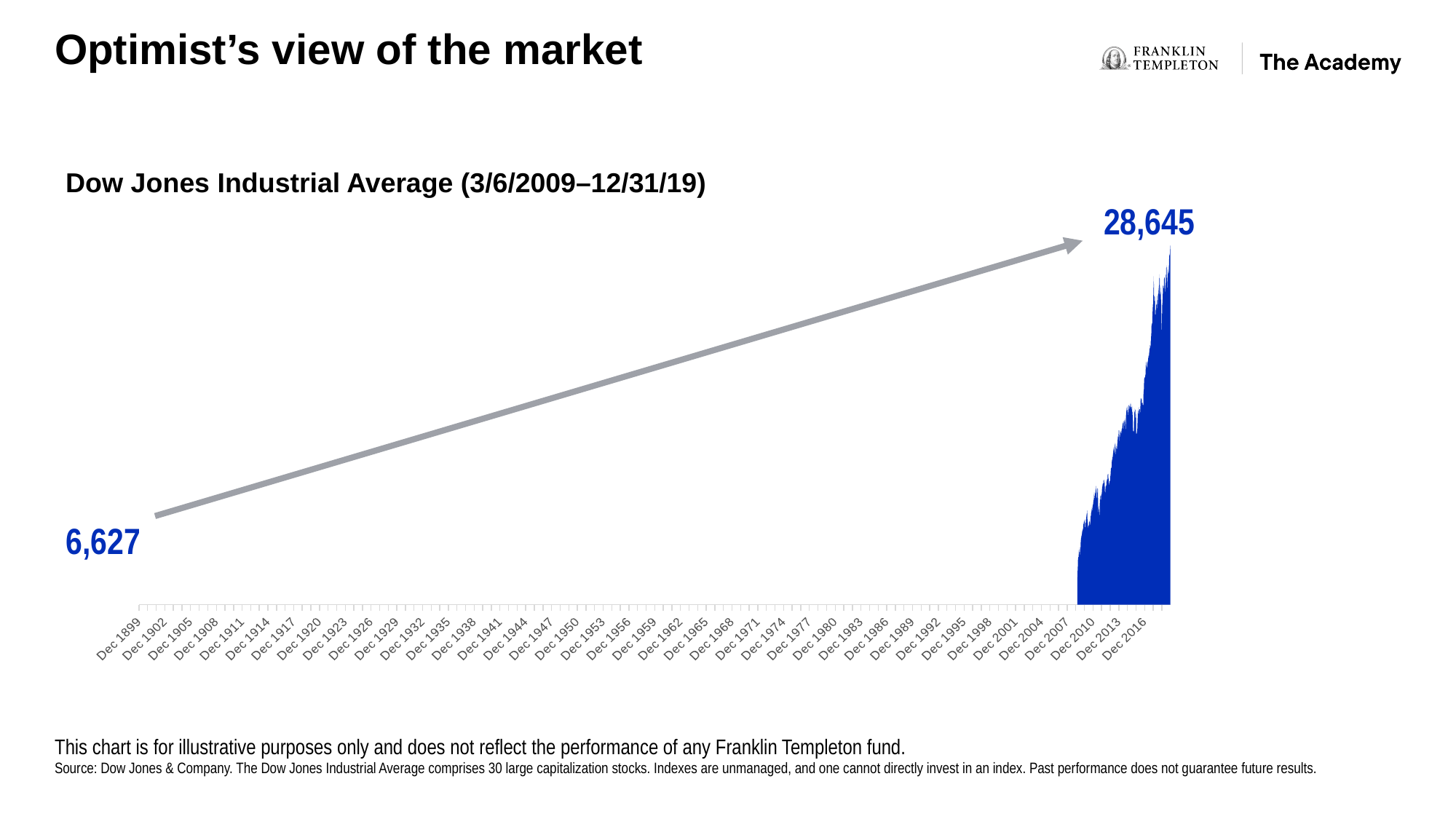
What date range is covered by the chart according to its title? 3/6/2009–12/31/19 What is the title of the chart? Dow Jones Industrial Average (3/6/2009–12/31/19) What is the starting value of the Dow Jones Industrial Average labelled on the chart? 6,627 What is the difference between the two labelled values, 28,645 and 6,627? 22,018 What is the ending value of the Dow Jones Industrial Average labelled on the chart? 28,645 What is the first label on the x axis of the chart? Dec 1899 Which labelled value is larger, the starting value or the ending value? The ending value, 28,645 Is the ending value of the Dow Jones Industrial Average greater or less than 20,000? greater Does the Dow Jones Industrial Average rise or fall over the period shown in the chart? Rise What is the last label on the x axis of the chart? Dec 2016 What kind of chart is used to show the Dow Jones Industrial Average? Area chart Is the starting value of the Dow Jones Industrial Average greater or less than 10,000? less